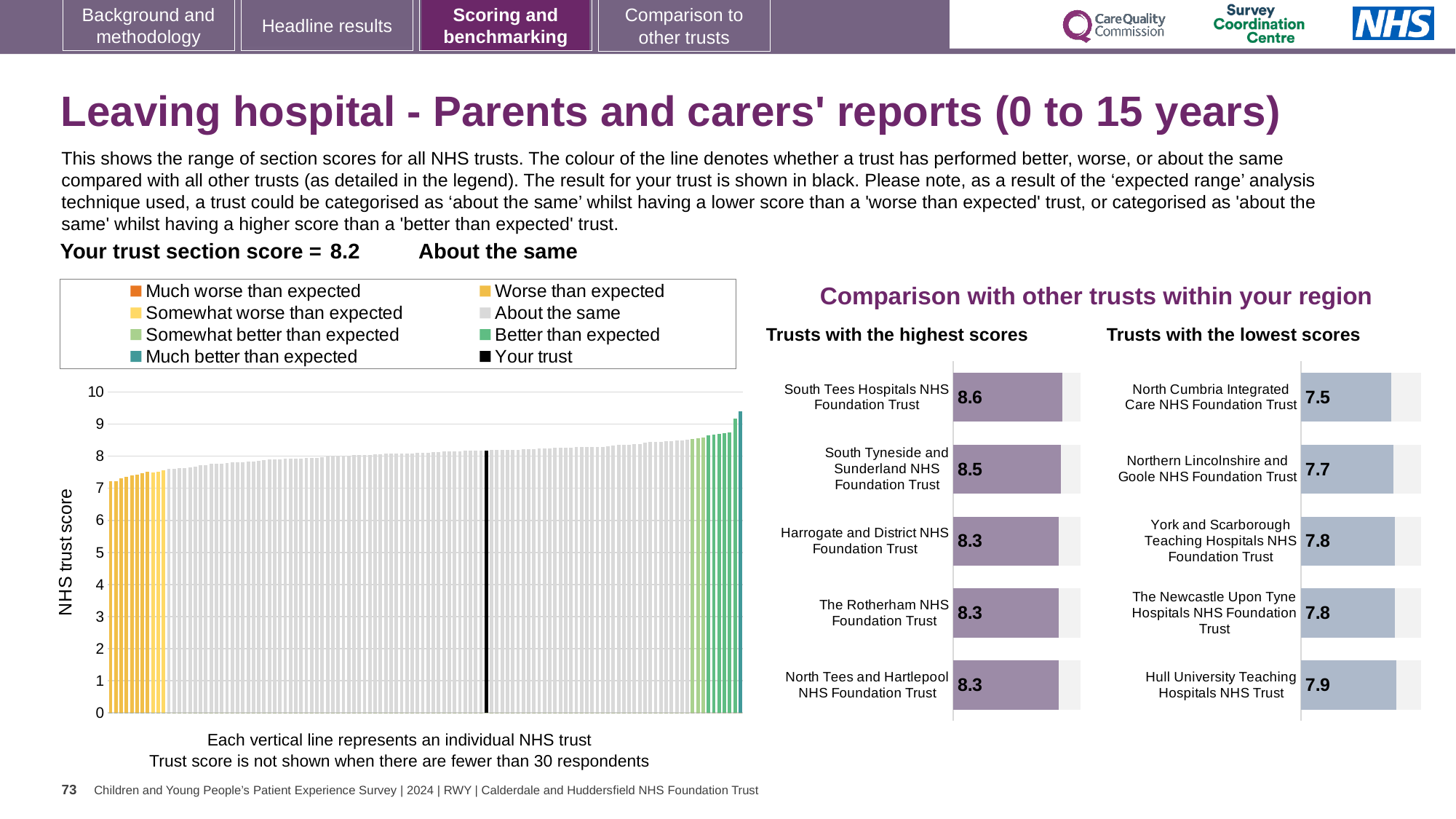
In the 'Trusts with the lowest scores' chart, what is the score for Hull University Teaching Hospitals NHS Trust? 7.9 What is the section score for your trust shown on the slide? 8.2 In the 'Trusts with the lowest scores' chart, which trust has the lowest score? North Cumbria Integrated Care NHS Foundation Trust What kind of chart is the large chart on the left showing NHS trust scores? Bar chart In the large chart on the left, do the trust scores rise or fall from left to right? Rise In the 'Trusts with the highest scores' chart, how many trusts are listed? 5 In the 'Trusts with the highest scores' chart, what is the difference between the scores of South Tees Hospitals NHS Foundation Trust and Harrogate and District NHS Foundation Trust? 0.3 In the 'Trusts with the highest scores' chart, what is the score for South Tees Hospitals NHS Foundation Trust? 8.6 In the 'Trusts with the lowest scores' chart, which has the higher score: Northern Lincolnshire and Goole NHS Foundation Trust or York and Scarborough Teaching Hospitals NHS Foundation Trust? York and Scarborough Teaching Hospitals NHS Foundation Trust In the 'Trusts with the highest scores' chart, which trust has the highest score? South Tees Hospitals NHS Foundation Trust In the 'Trusts with the lowest scores' chart, what is the difference between the scores of Hull University Teaching Hospitals NHS Trust and North Cumbria Integrated Care NHS Foundation Trust? 0.4 How many entries does the legend above the large chart on the left list? 8